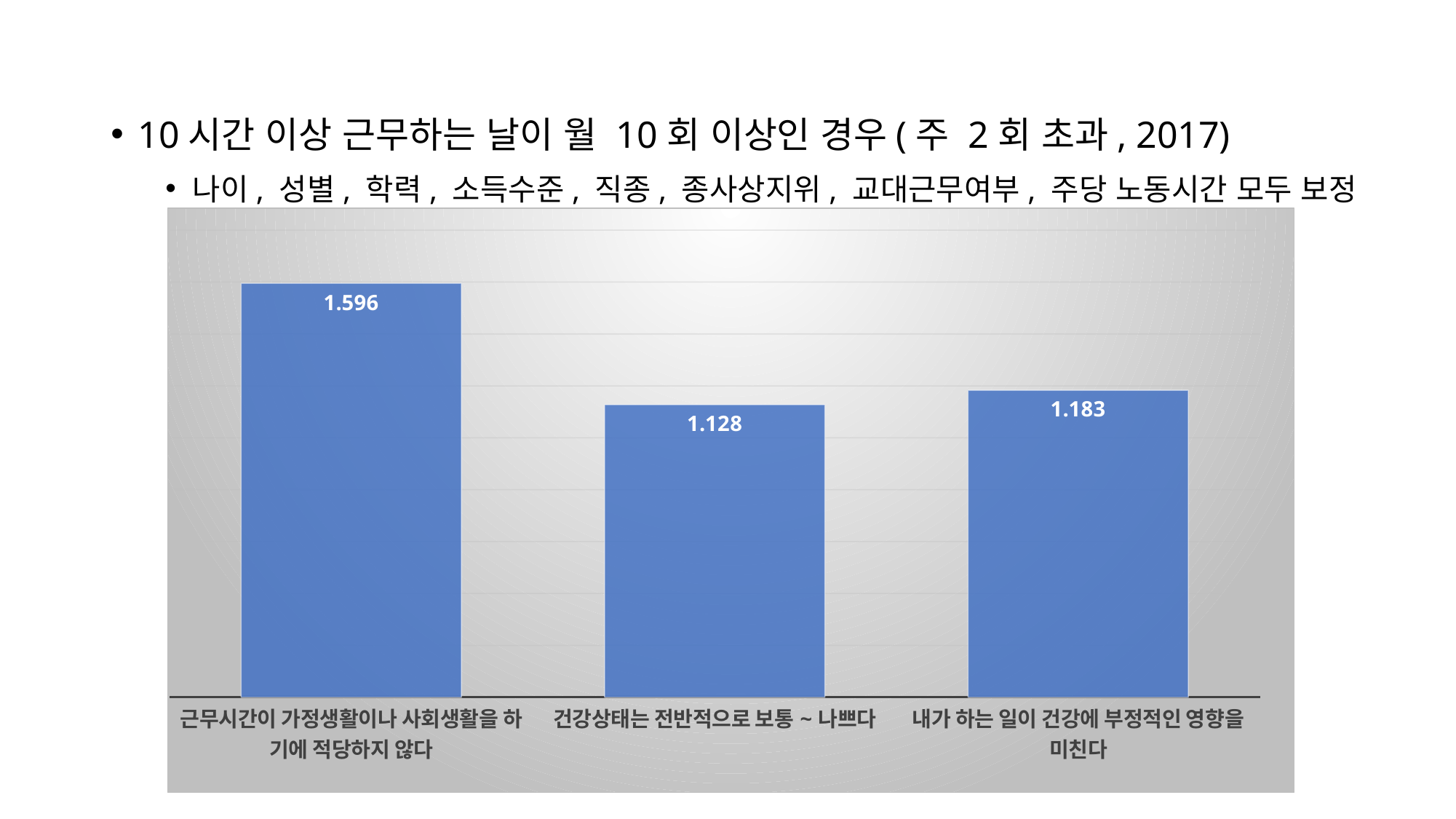
How many categories are shown in the chart? 3 Which category has the highest value? 근무시간이 가정생활이나 사회생활을 하기에 적당하지 않다 What is the value for '근무시간이 가정생활이나 사회생활을 하기에 적당하지 않다'? 1.596 What is the difference between the values for '근무시간이 가정생활이나 사회생활을 하기에 적당하지 않다' and '건강상태는 전반적으로 보통 ~ 나쁘다'? 0.468 Which category has the lowest value? 건강상태는 전반적으로 보통 ~ 나쁘다 What is the difference between the values for '내가 하는 일이 건강에 부정적인 영향을 미친다' and '건강상태는 전반적으로 보통 ~ 나쁘다'? 0.055 What is the value for '내가 하는 일이 건강에 부정적인 영향을 미친다'? 1.183 Which is larger: the value for '내가 하는 일이 건강에 부정적인 영향을 미친다' or the value for '건강상태는 전반적으로 보통 ~ 나쁘다'? 내가 하는 일이 건강에 부정적인 영향을 미친다 What kind of chart is shown on the slide? Bar chart What colour are the bars in the chart? Blue What is the value for '건강상태는 전반적으로 보통 ~ 나쁘다'? 1.128 Which is larger: the value for '근무시간이 가정생활이나 사회생활을 하기에 적당하지 않다' or the value for '내가 하는 일이 건강에 부정적인 영향을 미친다'? 근무시간이 가정생활이나 사회생활을 하기에 적당하지 않다